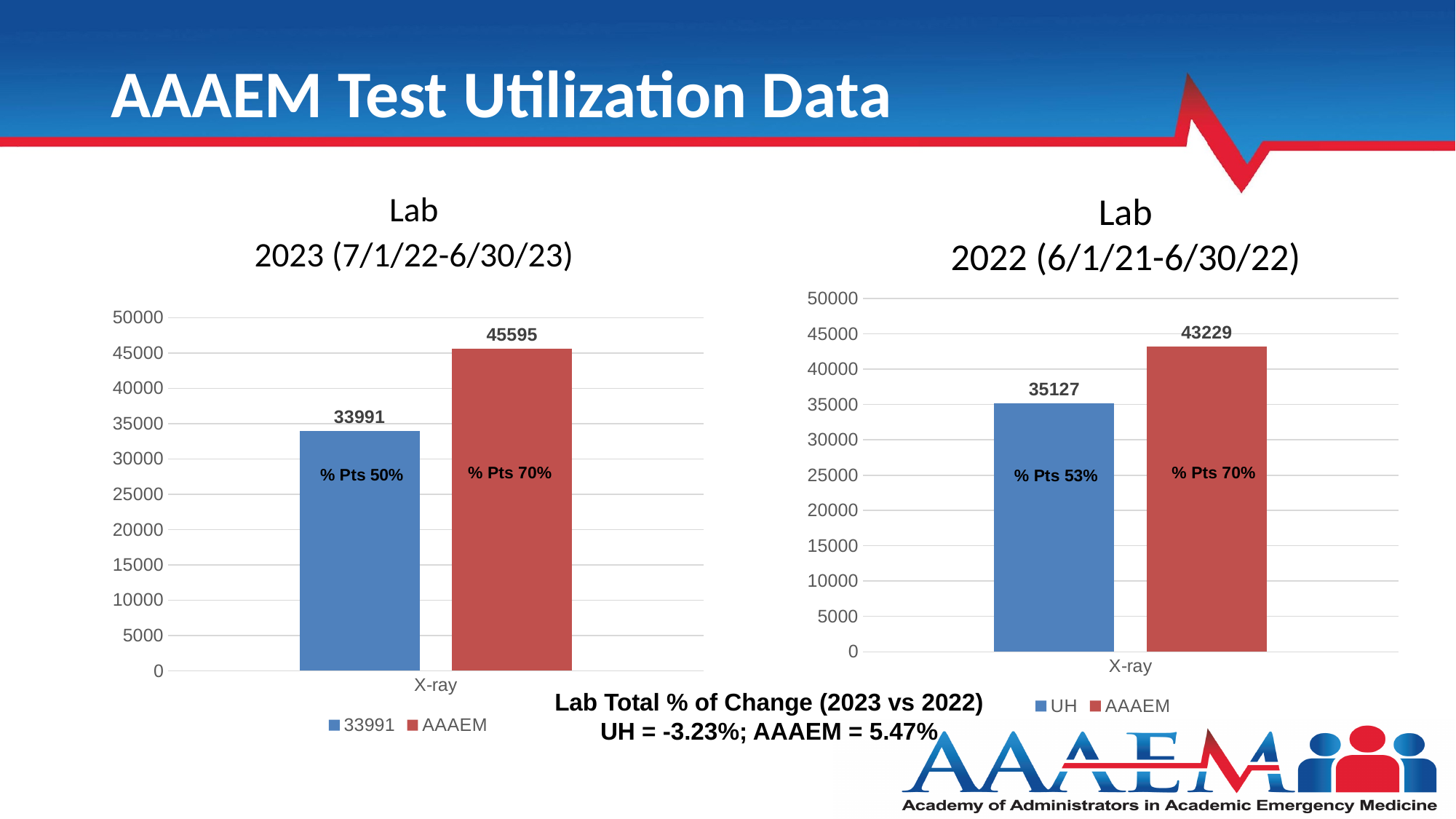
In the Lab 2023 (7/1/22-6/30/23) chart, what is the value of the AAAEM bar? 45595 In the Lab 2022 (6/1/21-6/30/22) chart, how many series does the legend list? 2 In the Lab 2022 (6/1/21-6/30/22) chart, what is the value for AAAEM? 43229 In the Lab 2022 (6/1/21-6/30/22) chart, what is the difference between the AAAEM and UH values? 8102 In the Lab 2023 (7/1/22-6/30/23) chart, what is the difference between the red AAAEM bar and the blue bar? 11604 What kind of chart is the Lab 2022 (6/1/21-6/30/22) chart? bar chart What is the category label on the x axis of the Lab 2023 (7/1/22-6/30/23) chart? X-ray In the Lab 2023 (7/1/22-6/30/23) chart, is the AAAEM value greater or less than 40000? greater In the Lab 2022 (6/1/21-6/30/22) chart, what is the value for UH? 35127 In the Lab 2022 (6/1/21-6/30/22) chart, which series has the higher value, UH or AAAEM? AAAEM In the Lab 2023 (7/1/22-6/30/23) chart, what is the value of the blue bar? 33991 In the Lab 2022 (6/1/21-6/30/22) chart, what percentage of patients label is shown on the UH bar? % Pts 53%